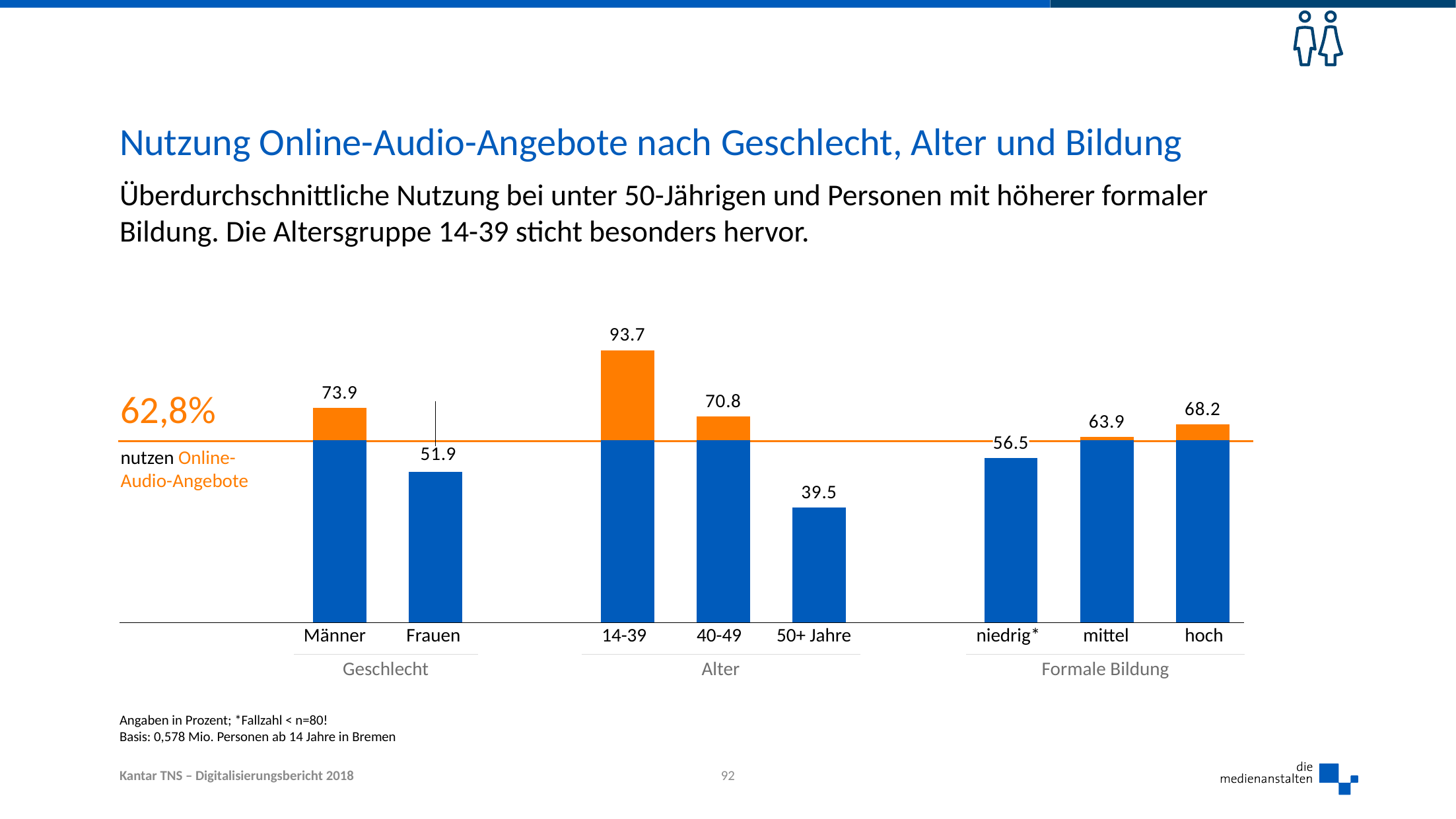
Which category has the lowest value? 50+ Jahre What is the value for Frauen? 51.9 What is the value for 50+ Jahre? 39.5 Which category has the highest value? 14-39 Which is larger, the value for 40-49 or the value for mittel? 40-49 What is the value for the 14-39 age group? 93.7 What is the value for the 'hoch' education group? 68.2 What is the difference between the values for Männer and Frauen? 22.0 What is the value for Männer? 73.9 What kind of chart is shown on the slide? bar chart What overall average value is marked by the horizontal line in the chart? 62,8% How many categories are shown in the chart? 8